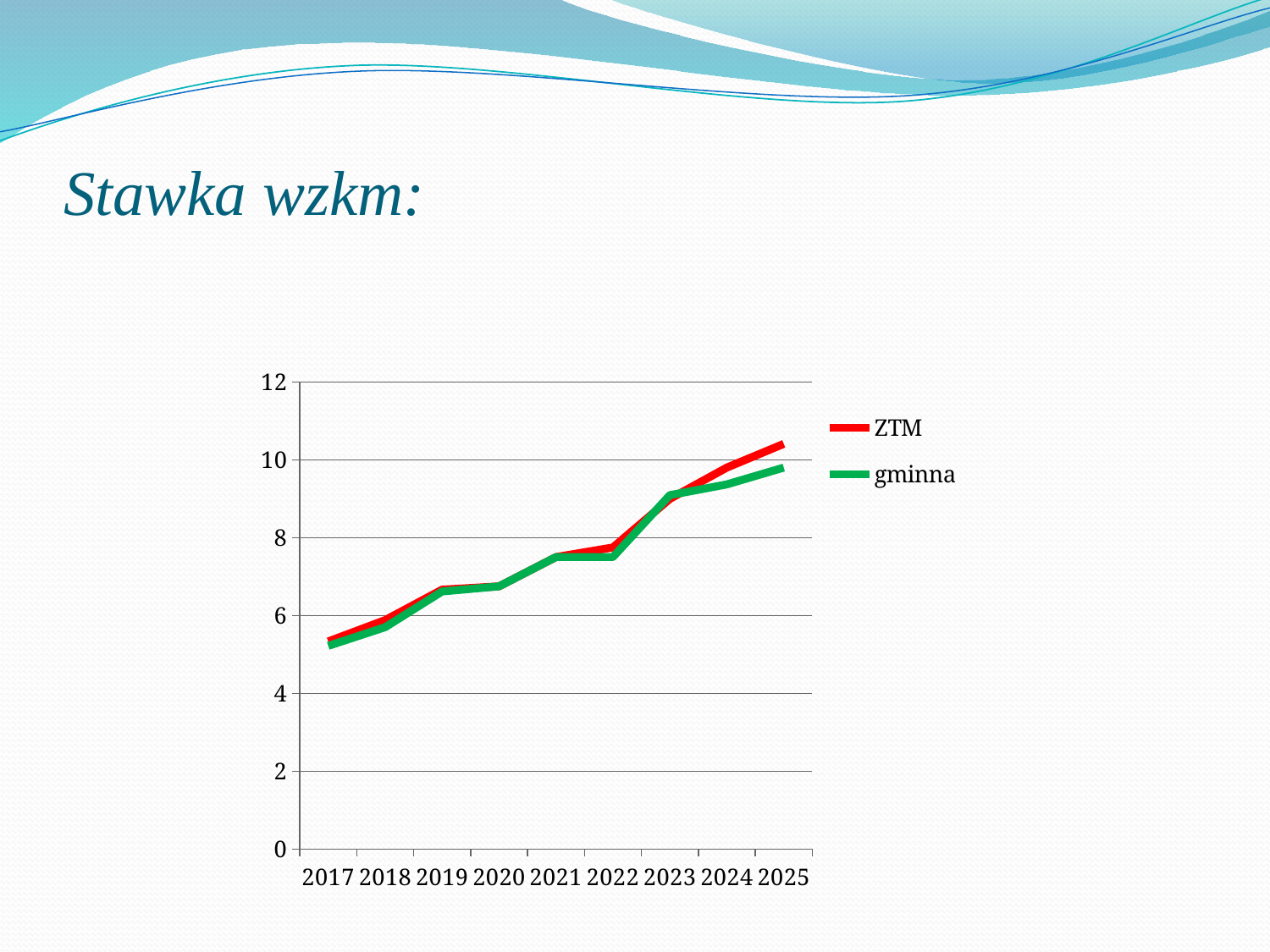
How many series does the legend list? 2 Is the value for ZTM in 2025 greater or less than 10? greater How many years are shown on the x axis? 9 Is the value for gminna in 2023 greater or less than 8? greater Is the value for gminna in 2025 greater or less than 10? less What colour is the line for the gminna series? green What kind of chart is shown on the slide? line chart Do the values for ZTM rise or fall from 2017 to 2025? rise In 2025, which series has the larger value, ZTM or gminna? ZTM In which year is the gminna value lowest? 2017 In which year is the ZTM value highest? 2025